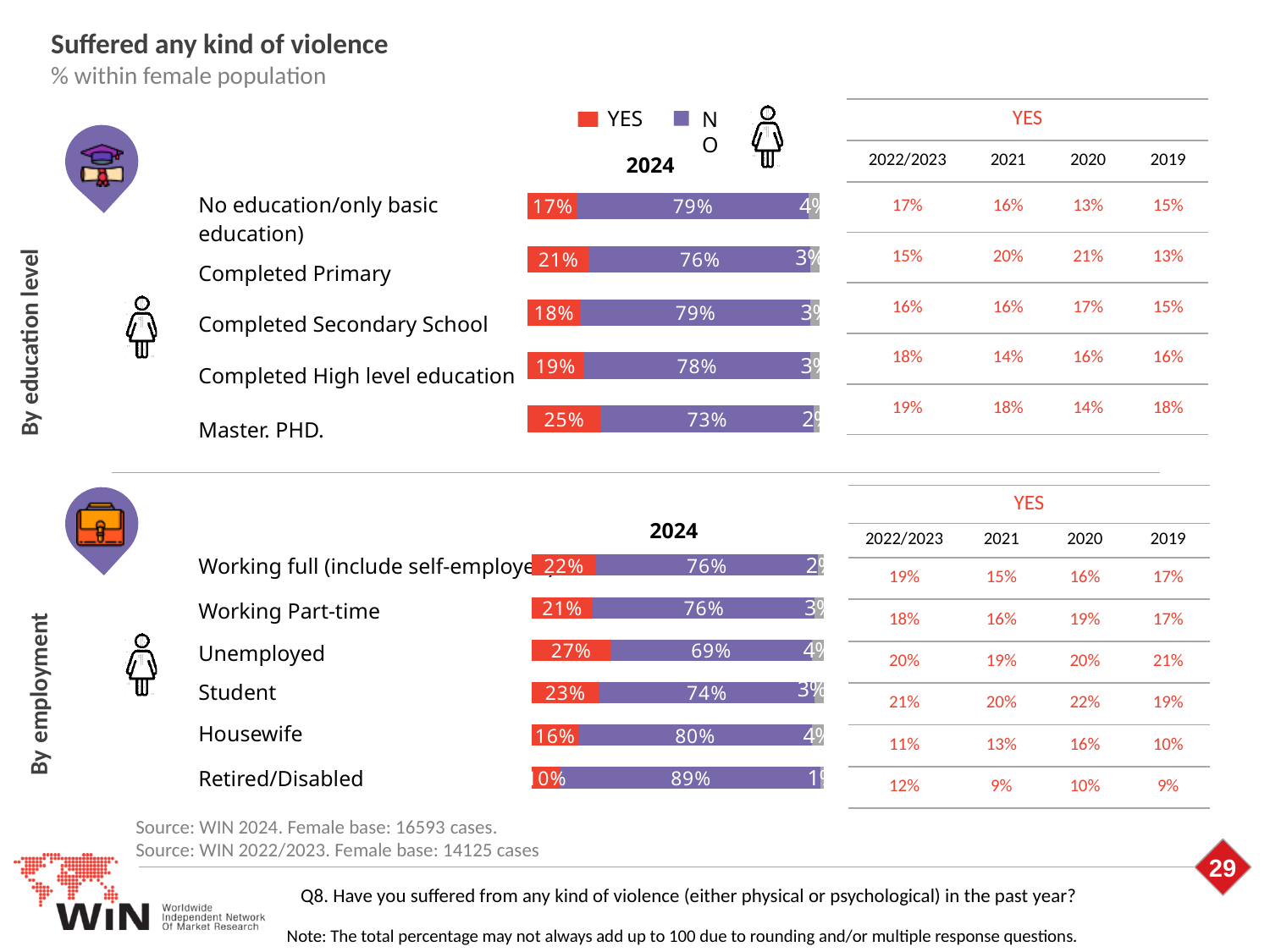
In the 'By employment' chart, what is the 2024 NO value for Housewife? 80% How many series does the legend of the 'By education level' chart list? 2 In the 'By education level' chart, which category has the highest 2024 YES value? Master. PHD. In the 'By employment' chart, which has the larger 2024 YES value: Student or Working Part-time? Student How many categories are shown in the 'By employment' chart? 6 In the 'By education level' chart, what is the difference between the 2024 YES values for Master. PHD. and No education/only basic education? 8 percentage points What kind of chart is used in the 'By employment' section? Stacked bar chart In the 'By employment' chart, what is the 2024 NO value for Retired/Disabled? 89% In the 'By education level' chart, what is the 2024 YES value for Master. PHD.? 25% How many categories are shown in the 'By education level' chart? 5 In the 'By employment' chart, which category has the lowest 2024 YES value? Retired/Disabled In the 'By employment' chart, which category has the highest 2024 YES value? Unemployed